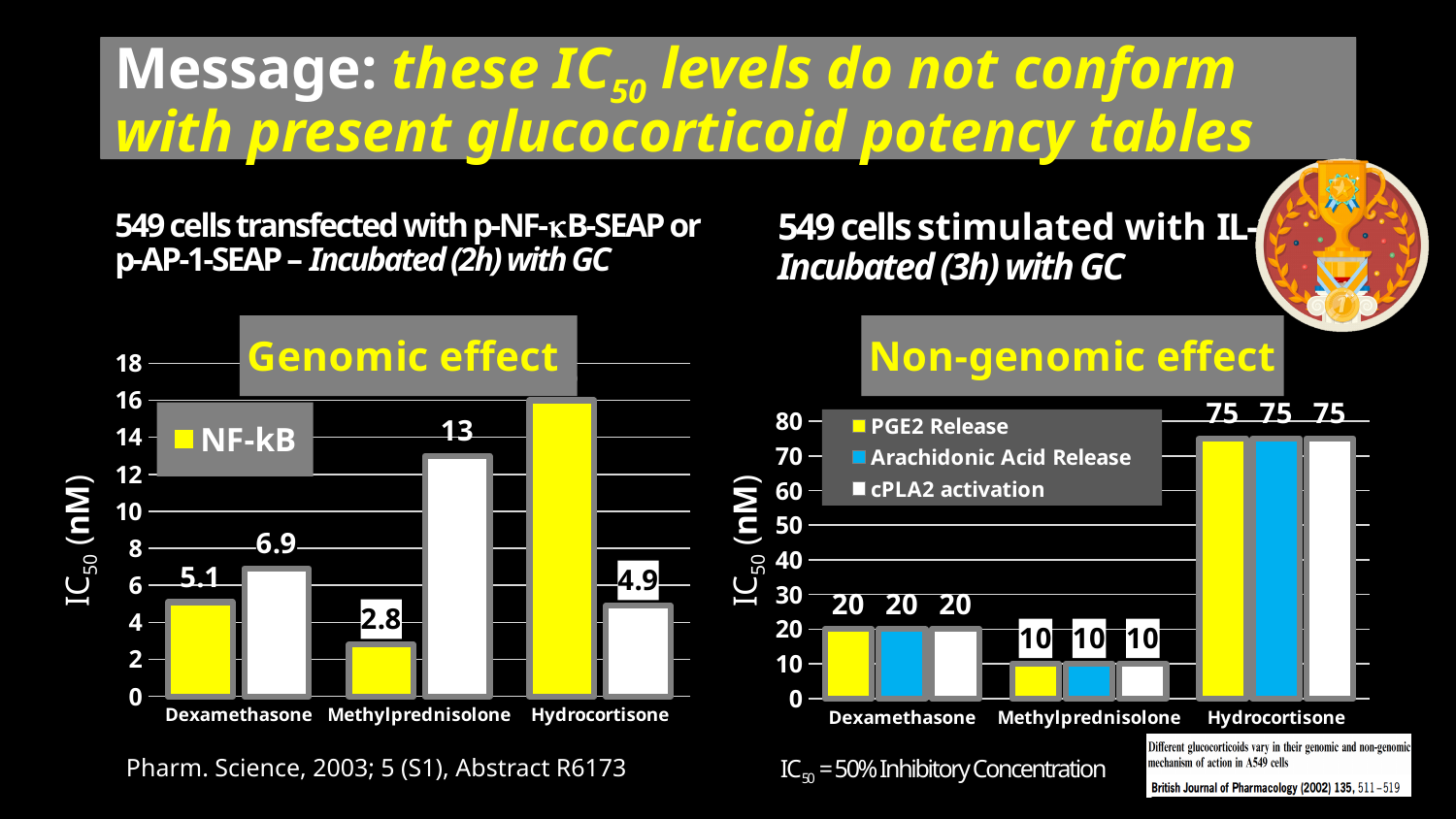
In the Non-genomic effect chart, which drug has the highest Arachidonic Acid Release value? Hydrocortisone What kind of chart is the Non-genomic effect chart? Bar chart In the Non-genomic effect chart, what is the cPLA2 activation value for Methylprednisolone? 10 In the Genomic effect chart, what value is labelled on the white bar for Methylprednisolone? 13 In the Non-genomic effect chart, what is the difference between the PGE2 Release values for Hydrocortisone and Dexamethasone? 55 In the Non-genomic effect chart, how many series does the legend list? 3 In the Non-genomic effect chart, what is the PGE2 Release value for Hydrocortisone? 75 In the Genomic effect chart, what is the NF-kB IC50 value for Methylprednisolone? 2.8 In the Genomic effect chart, which drug has the lowest NF-kB IC50 value? Methylprednisolone In the Genomic effect chart, is the NF-kB value for Hydrocortisone greater or less than 14? greater In the Genomic effect chart, what is the NF-kB IC50 value for Dexamethasone? 5.1 In the Genomic effect chart, what is the difference between the white bar for Dexamethasone (6.9) and the NF-kB bar for Dexamethasone (5.1)? 1.8